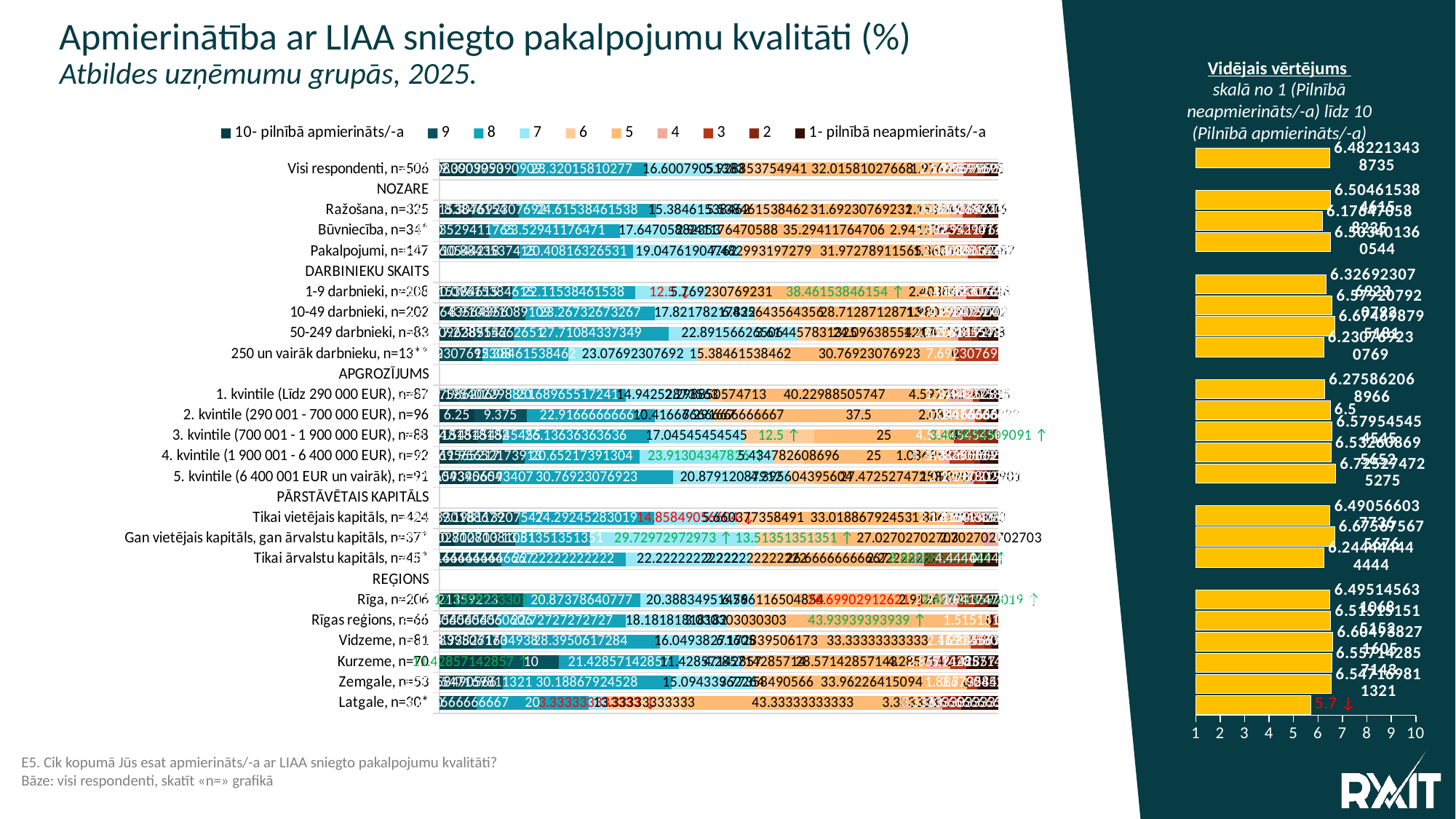
What kind of chart is the main chart on the left of the slide? Bar chart In the stacked bar chart, what is the value of the '5' series for 'Latgale, n=30*'? 43.33333333333 In the stacked bar chart, what is the value of the '5' series for '3. kvintile (700 001 - 1 900 000 EUR), n=88'? 25 In the 'Vidējais vērtējums' chart on the right, is the average rating for 'Latgale, n=30*' greater or less than 6? less How many series does the legend of the stacked bar chart list? 10 In the 'Vidējais vērtējums' chart on the right, which group has the lowest average rating? Latgale, n=30* In the stacked bar chart, what is the difference between the '5' series values for '2. kvintile (290 001 - 700 000 EUR), n=96' and '3. kvintile (700 001 - 1 900 000 EUR), n=88'? 12.5 In the stacked bar chart, what is the value of the '8' series for '250 un vairāk darbinieku, n=13**'? 15.38461538462 In the stacked bar chart, which has the larger '5' series value: '2. kvintile (290 001 - 700 000 EUR), n=96' or '3. kvintile (700 001 - 1 900 000 EUR), n=88'? 2. kvintile (290 001 - 700 000 EUR), n=96 In the 'Vidējais vērtējums' chart on the right, what is the average rating for 'Latgale, n=30*'? 5.7 In the stacked bar chart, what is the value of the '5' series for '2. kvintile (290 001 - 700 000 EUR), n=96'? 37.5 In the 'Vidējais vērtējums' chart on the right, is the average rating for 'Visi respondenti, n=506' greater or less than 6? greater